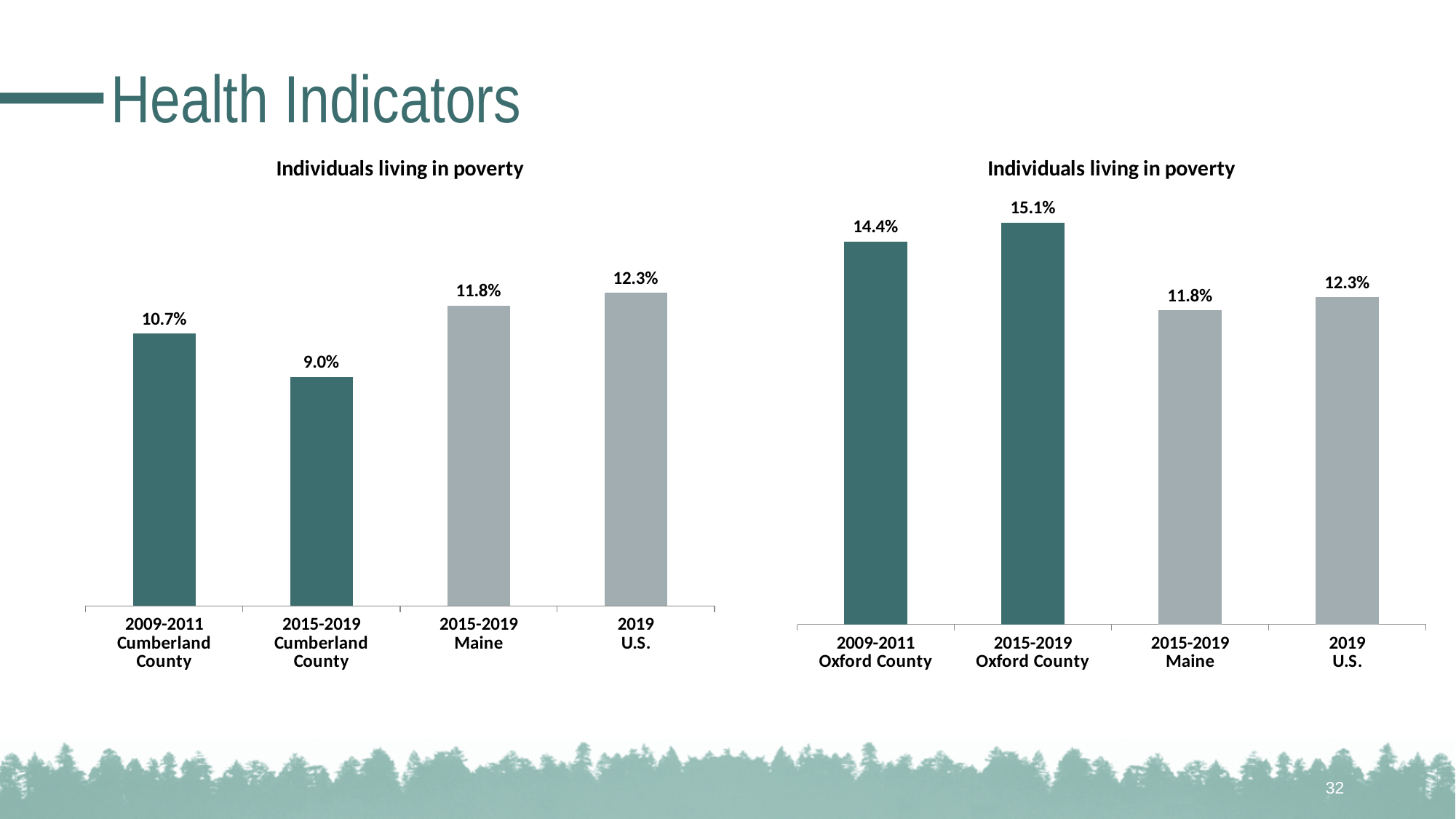
In the left chart (Cumberland County), which category has the lowest value? 2015-2019 Cumberland County In the left chart (Cumberland County), what is the value for 2015-2019 Cumberland County? 9.0% How many bars are shown in the right chart (Oxford County)? 4 In the left chart (Cumberland County), which category has the highest value? 2019 U.S. What type of chart is the left chart (Cumberland County)? Bar chart In the right chart (Oxford County), what is the value for 2009-2011 Oxford County? 14.4% In the right chart (Oxford County), what is the difference between the 2015-2019 Oxford County value and the 2015-2019 Maine value? 3.3% In the left chart (Cumberland County), which is larger: the 2015-2019 Cumberland County value or the 2015-2019 Maine value? 2015-2019 Maine In the left chart (Cumberland County), what is the value for 2009-2011 Cumberland County? 10.7% In the right chart (Oxford County), which category has the lowest value? 2015-2019 Maine In the right chart (Oxford County), what is the value for 2015-2019 Oxford County? 15.1% In the right chart (Oxford County), which category has the highest value? 2015-2019 Oxford County